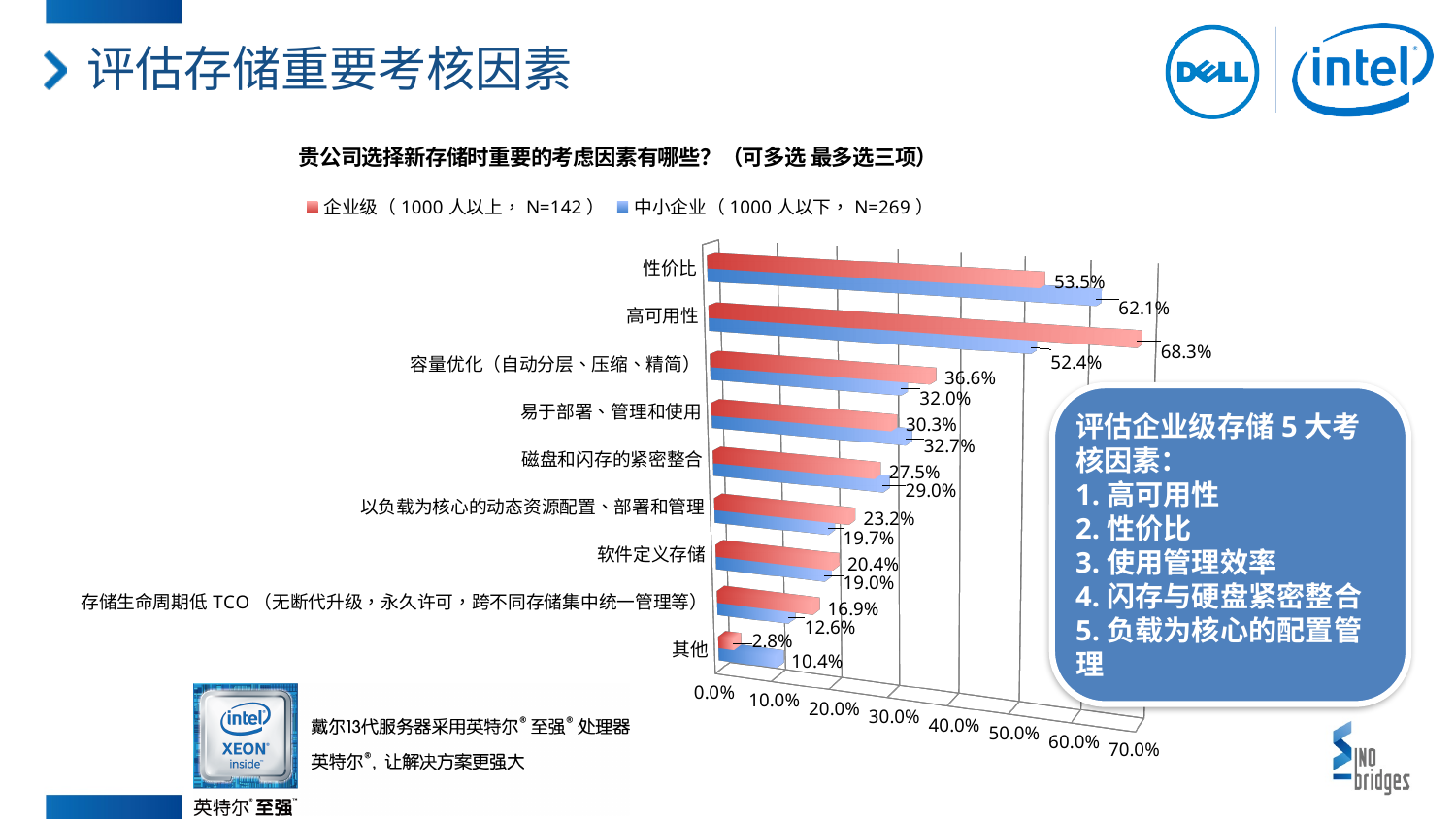
What is the value for 中小企业 for 其他? 10.4% What is the value for 企业级 (1000人以上, N=142) for 高可用性? 68.3% Is the 企业级 value for 容量优化（自动分层、压缩、精简） greater or less than 30.0%? greater What is the value for 中小企业 (1000人以下, N=269) for 性价比? 62.1% What kind of chart is shown on the slide? bar chart For 性价比, which series has the larger value, 企业级 or 中小企业? 中小企业 Which category has the highest value for the 企业级 series? 高可用性 Which category has the lowest value for the 中小企业 series? 其他 What is the difference between the 企业级 and 中小企业 values for 高可用性? 15.9% How many series does the legend list? 2 What is the value for 企业级 for 软件定义存储? 20.4% How many categories are shown on the chart? 9